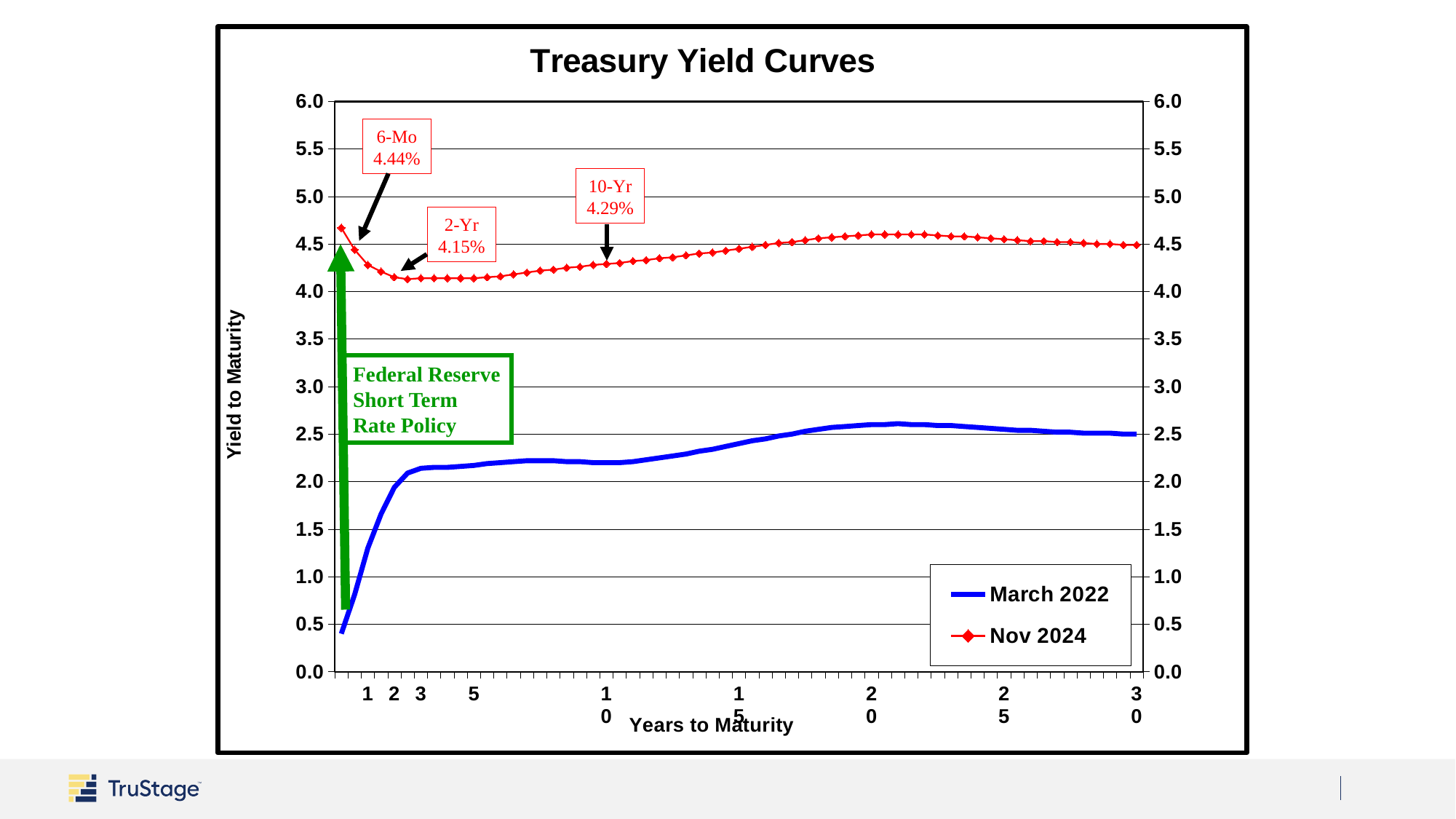
Is the March 2022 yield at 30 years to maturity greater or less than 3.0? less Is the Nov 2024 yield at 30 years to maturity greater or less than 4.0? greater Which is higher on the Nov 2024 curve, the 6-month yield or the 10-year yield? 6-month yield At 10 years to maturity, which series has the higher yield, March 2022 or Nov 2024? Nov 2024 What is the 6-month yield on the Nov 2024 curve? 4.44% What kind of chart is shown on the slide? Line chart On the Nov 2024 curve, what is the difference between the 10-year yield and the 2-year yield? 0.14% How many series does the legend list? 2 On the Nov 2024 curve, how much higher is the 6-month yield than the 2-year yield? 0.29% What is the 2-year yield on the Nov 2024 curve? 4.15% What is the 10-year yield on the Nov 2024 curve? 4.29% What is the title of the chart? Treasury Yield Curves